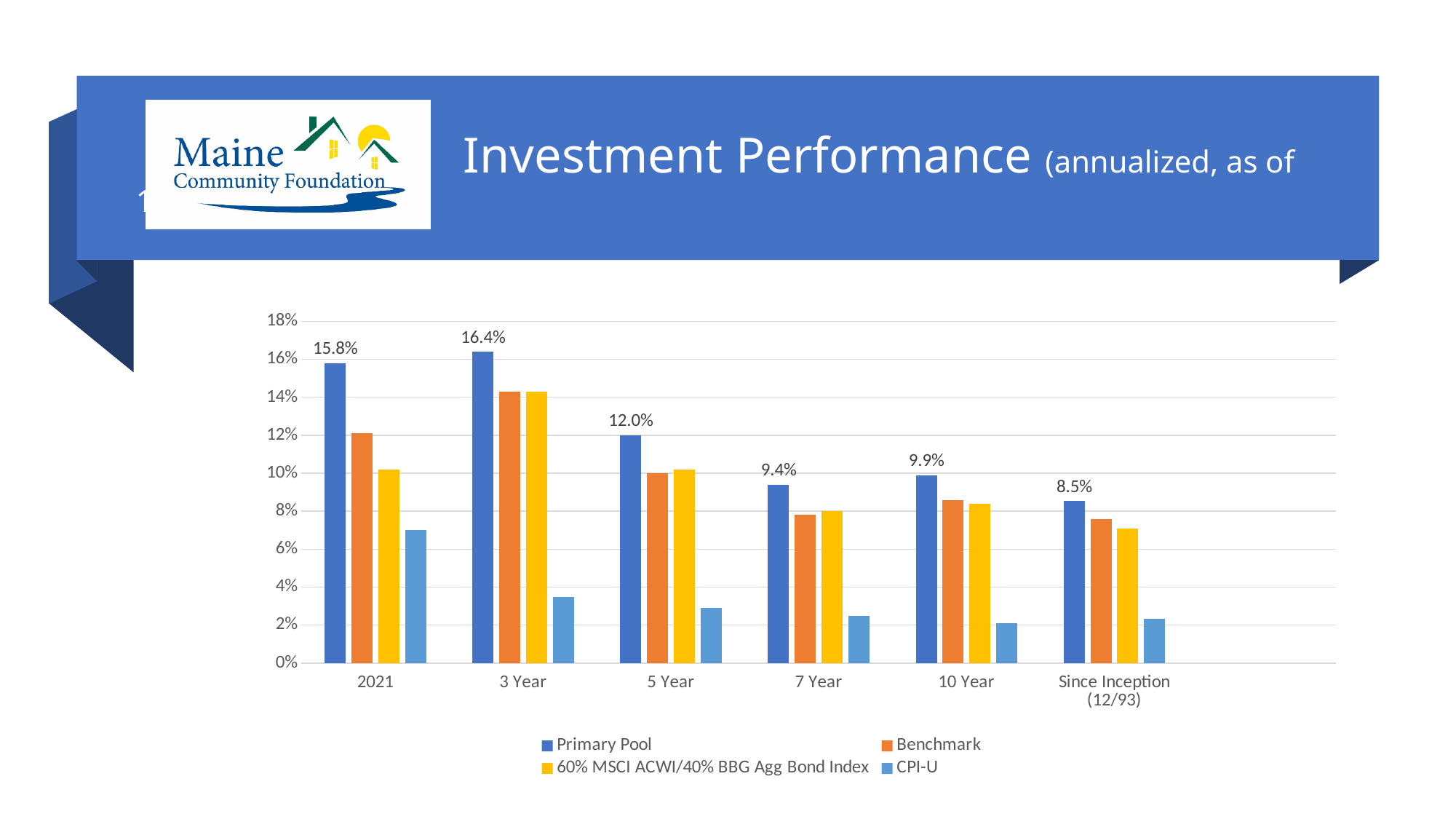
How many time periods are shown on the x axis? 6 For which period is the Primary Pool value lowest? Since Inception (12/93) What is the Primary Pool value for the 7 Year period? 9.4% Is the CPI-U value for 2021 greater or less than 6%? greater What is the difference between the Primary Pool values for the 5 Year and 7 Year periods? 2.6 percentage points For which period is the Primary Pool value highest? 3 Year Is the CPI-U value for the 10 Year period greater or less than 4%? less What is the Primary Pool value for the 3 Year period? 16.4% What is the Primary Pool value for 2021? 15.8% Which is larger for the Primary Pool: the 10 Year value or the 7 Year value? 10 Year What is the Primary Pool value for Since Inception (12/93)? 8.5% How many series does the legend list? 4